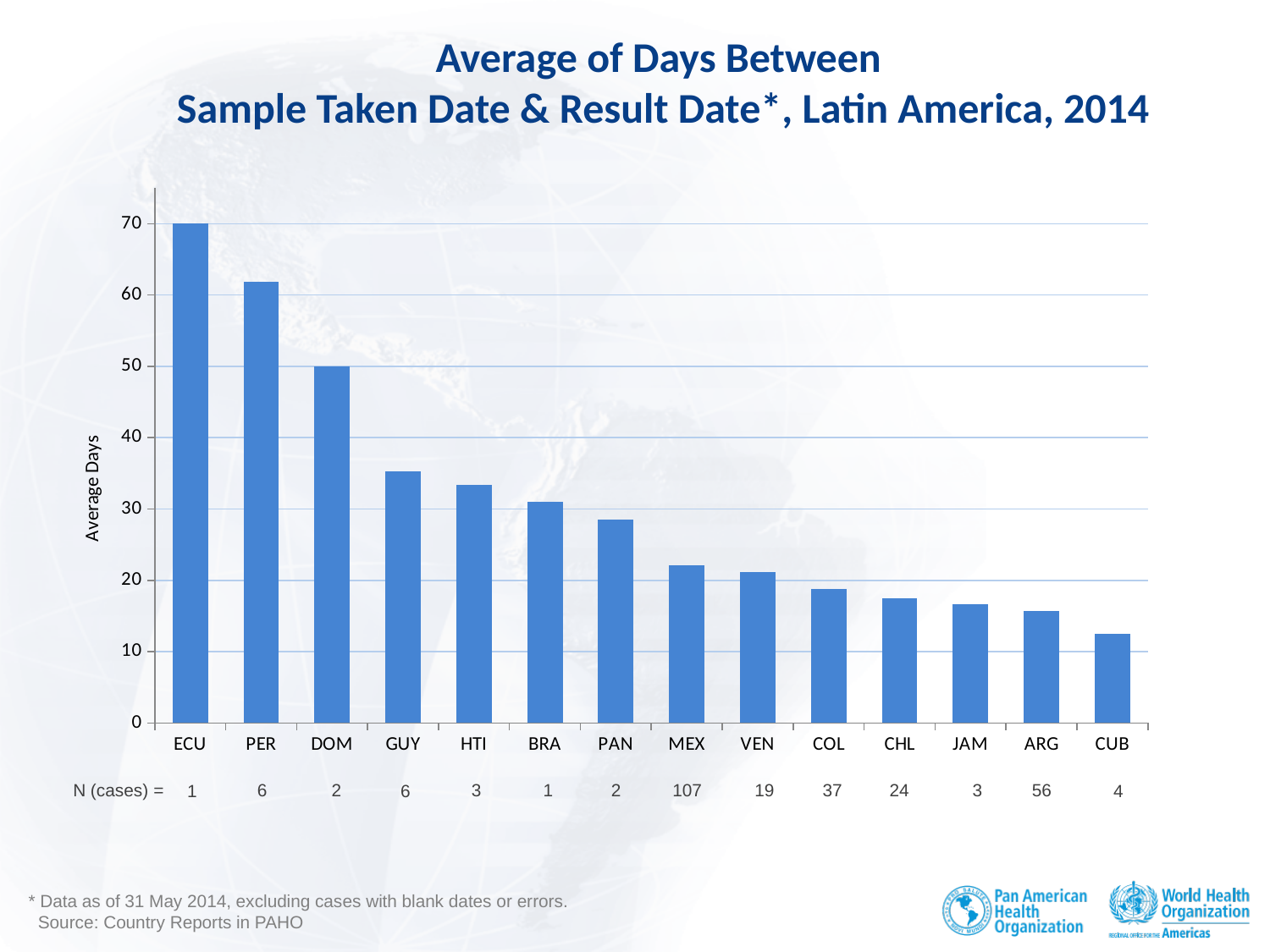
Is the value for CUB greater or less than 10? greater Which has a larger average number of days, PER or DOM? PER Which country has the highest average number of days between sample taken date and result date? ECU Is the value for MEX greater or less than 20? greater What kind of chart is shown on the slide? bar chart What is the label on the y axis of the chart? Average Days Do the bar values rise or fall moving from left to right along the x axis? fall Is the value for GUY greater or less than 30? greater Which country has the lowest average number of days between sample taken date and result date? CUB How many countries are shown on the x axis of the chart? 14